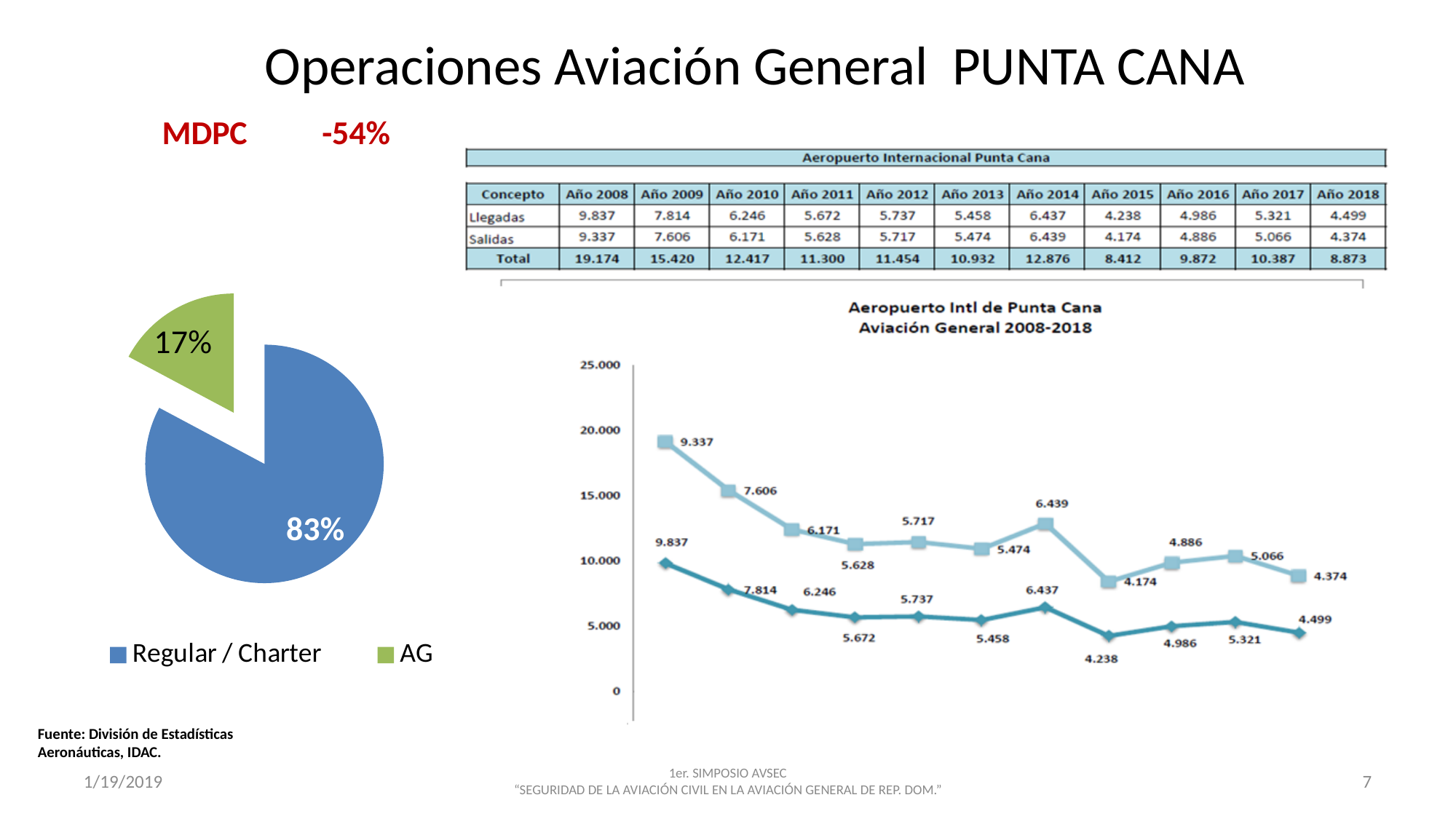
In the 'Aeropuerto Intl de Punta Cana Aviación General 2008-2018' chart, what is the lowest data label on the lower (darker) line? 4.238 In the 'Aeropuerto Intl de Punta Cana Aviación General 2008-2018' chart, what is the data label on the last point of the upper (lighter) line? 4.374 In the 'Aeropuerto Intl de Punta Cana Aviación General 2008-2018' chart, do the values generally rise or fall from left to right? Fall In the 'Aeropuerto Intl de Punta Cana Aviación General 2008-2018' chart, how many data points does each line have? 11 How many entries does the legend of the pie chart list? 2 In the pie chart, what share is shown for Regular / Charter? 83% What kind of chart is the 'Aeropuerto Intl de Punta Cana Aviación General 2008-2018' chart? Line chart What kind of chart is the chart on the left of the slide? Pie chart In the pie chart, which slice is larger, Regular / Charter or AG? Regular / Charter In the 'Aeropuerto Intl de Punta Cana Aviación General 2008-2018' chart, what is the data label on the first point of the upper (lighter) line? 9.337 In the pie chart, what share is shown for AG? 17% In the pie chart, by how many percentage points does the Regular / Charter share exceed the AG share? 66 percentage points